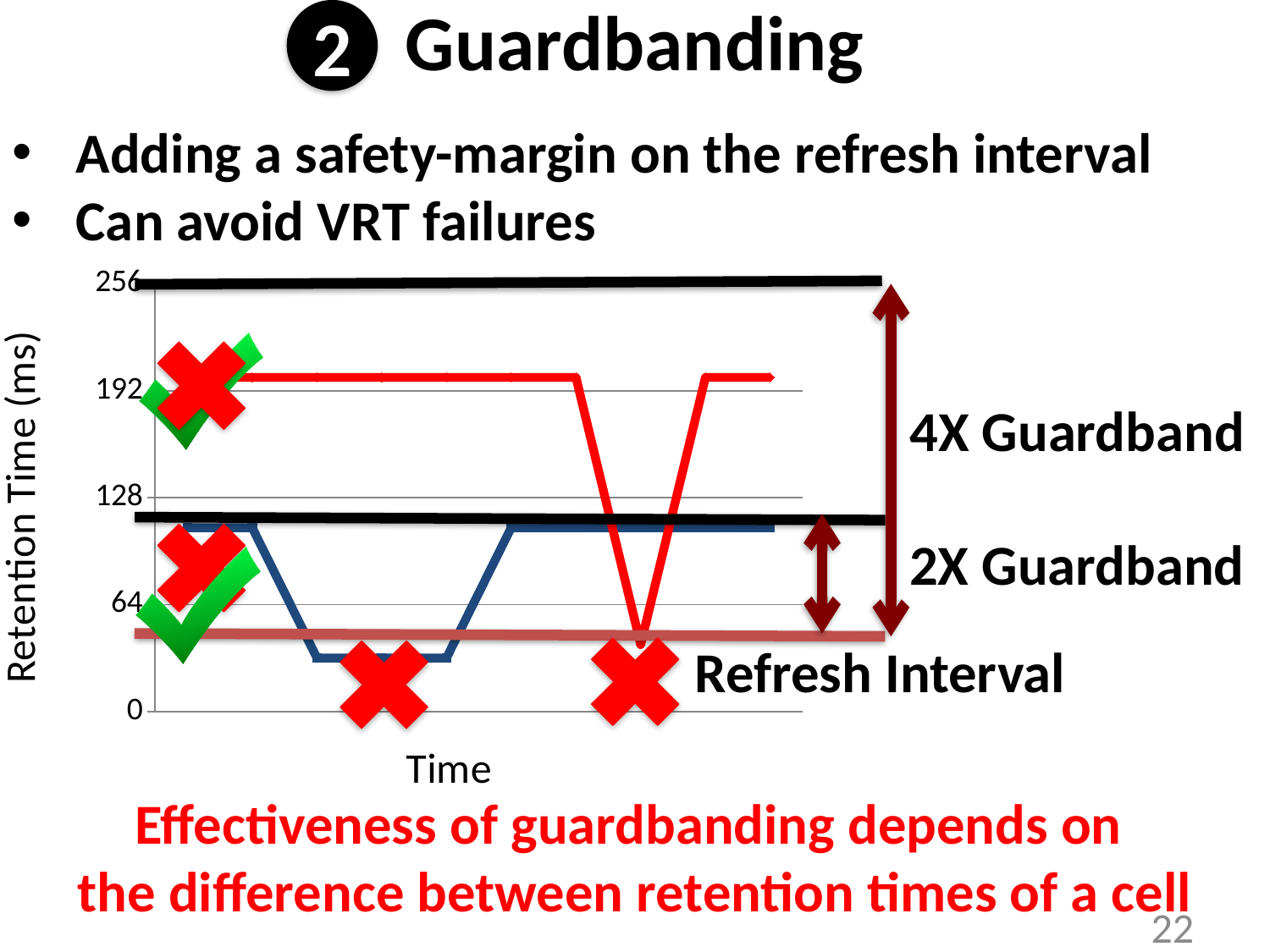
Is the lowest point of the blue line greater or less than 64? less Is the highest level of the blue line greater or less than 128? less Is the highest level of the red line greater or less than 128? greater At the start of the chart, which line has the higher retention time, the red line or the blue line? the red line What is the highest value shown on the y axis of the chart? 256 How many lines (series) are plotted on the chart? 2 What is the label of the x axis of the chart? Time What kind of chart is shown on the slide? line chart What is the label of the y axis of the chart? Retention Time (ms)